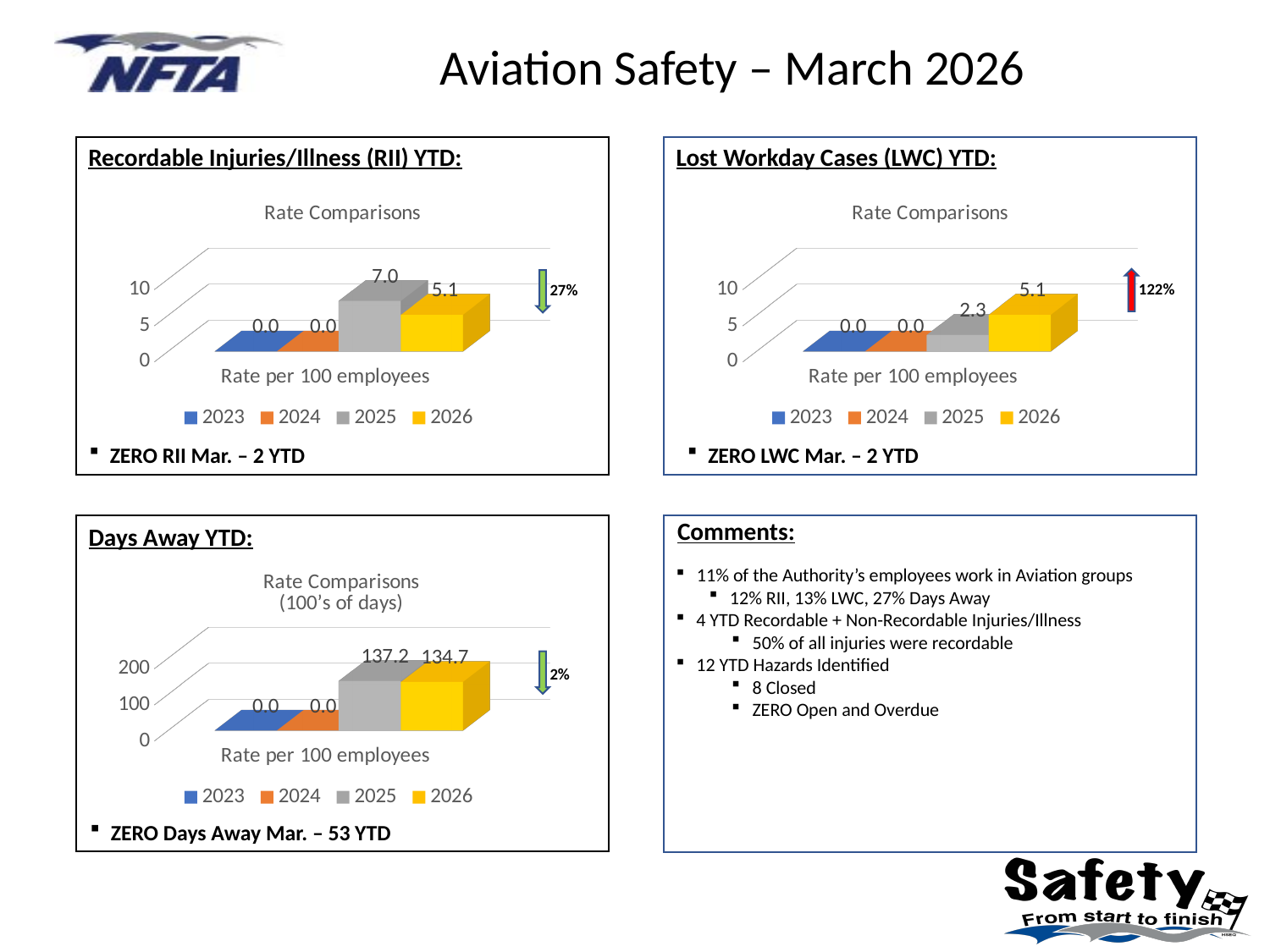
What kind of chart is the Lost Workday Cases (LWC) YTD chart? bar chart In the Lost Workday Cases (LWC) YTD chart, what is the value for 2025? 2.3 In the Recordable Injuries/Illness (RII) YTD chart, what is the value for 2025? 7.0 In the Days Away YTD chart, what is the difference between the 2025 and 2026 values? 2.5 In the Lost Workday Cases (LWC) YTD chart, which year has the highest value? 2026 In the Days Away YTD chart, what is the value for 2025? 137.2 In the Recordable Injuries/Illness (RII) YTD chart, what is the value for 2026? 5.1 In the Recordable Injuries/Illness (RII) YTD chart, what is the difference between the 2025 and 2026 values? 1.9 In the Recordable Injuries/Illness (RII) YTD chart, which year has the highest value? 2025 How many series does the legend of the Days Away YTD chart list? 4 In the Days Away YTD chart, what is the value for 2026? 134.7 In the Lost Workday Cases (LWC) YTD chart, is the value for 2026 larger or smaller than the value for 2025? larger